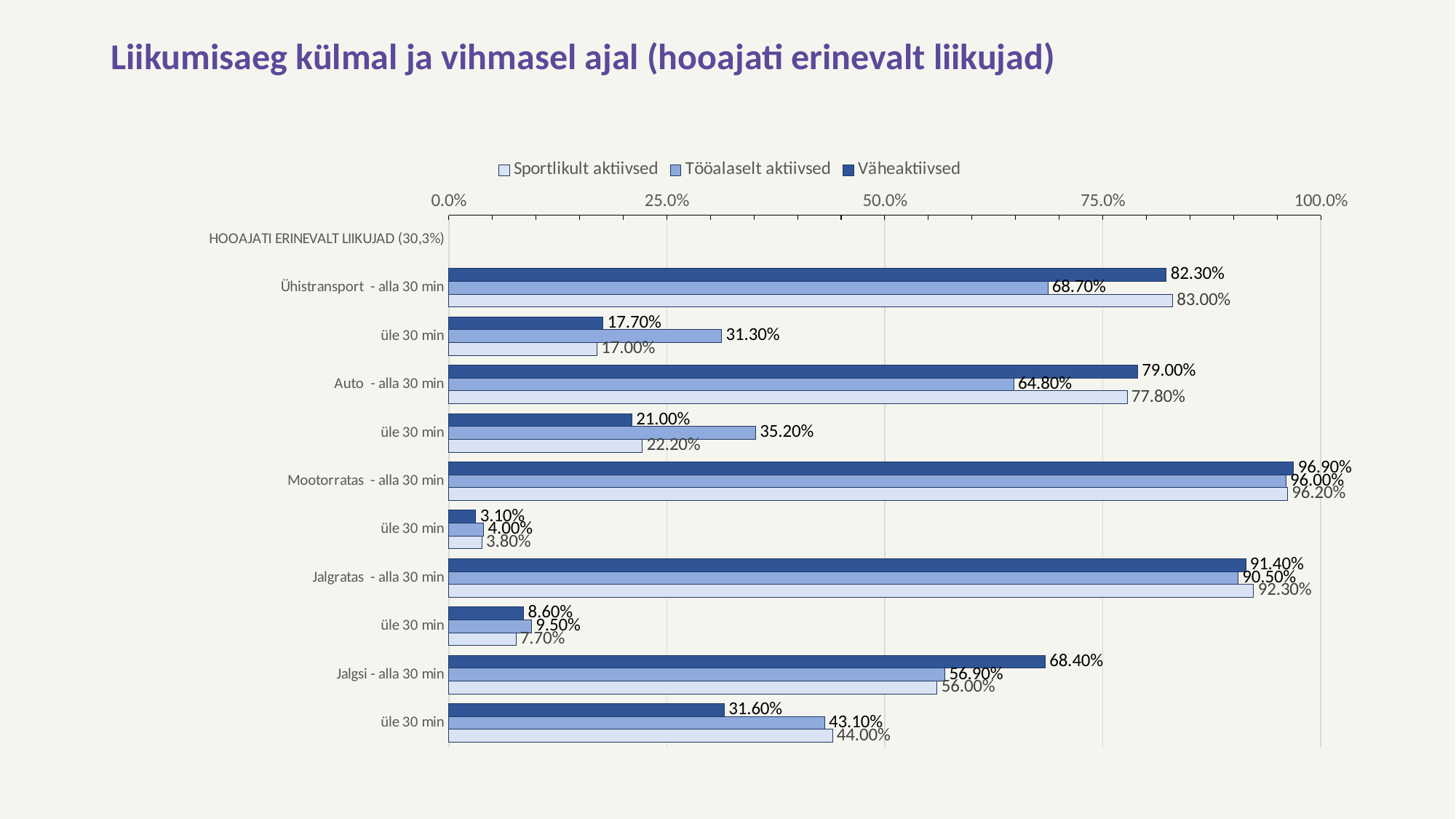
Is the Sportlikult aktiivsed value for Jalgratas - alla 30 min greater or less than 75.0%? greater What type of chart is shown on the slide? bar chart What is the value for Tööalaselt aktiivsed for Auto - üle 30 min? 35.20% What is the difference between the Väheaktiivsed and Tööalaselt aktiivsed values for Jalgsi - alla 30 min? 11.50% Which series has the highest value for Jalgsi - alla 30 min? Väheaktiivsed How many series does the legend list? 3 What is the value for Väheaktiivsed for Ühistransport - alla 30 min? 82.30% Which series has the lowest value for Ühistransport - üle 30 min? Sportlikult aktiivsed What is the value for Väheaktiivsed for Mootorratas - alla 30 min? 96.90% For Auto - alla 30 min, which is larger: the Väheaktiivsed value or the Tööalaselt aktiivsed value? Väheaktiivsed What is the title of the chart on the slide? Liikumisaeg külmal ja vihmasel ajal (hooajati erinevalt liikujad) What is the value for Sportlikult aktiivsed for Jalgsi - üle 30 min? 44.00%